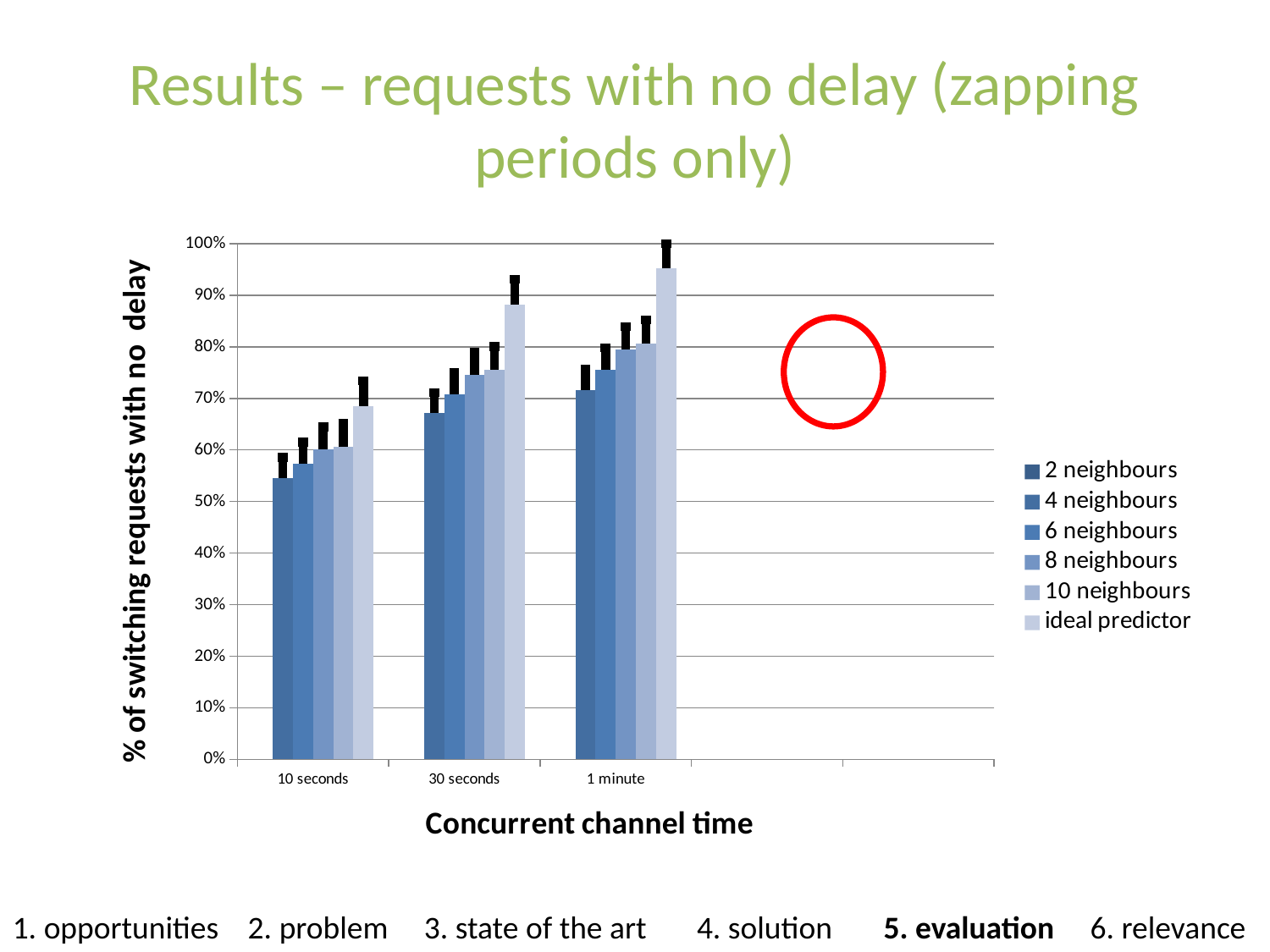
What is the label of the x axis? Concurrent channel time Which series has the highest value in the 1 minute group? ideal predictor Do the values for the ideal predictor series rise or fall from 10 seconds to 1 minute? rise Is the value for ideal predictor at 1 minute greater or less than 90%? greater How many labelled categories are shown on the x axis? 3 How many series does the legend list? 6 What kind of chart is shown on the slide? bar chart Is the value for ideal predictor at 30 seconds greater or less than 80%? greater Is the value for 2 neighbours at 30 seconds greater or less than 70%? less Which is larger: the ideal predictor value at 1 minute or the 2 neighbours value at 10 seconds? ideal predictor at 1 minute